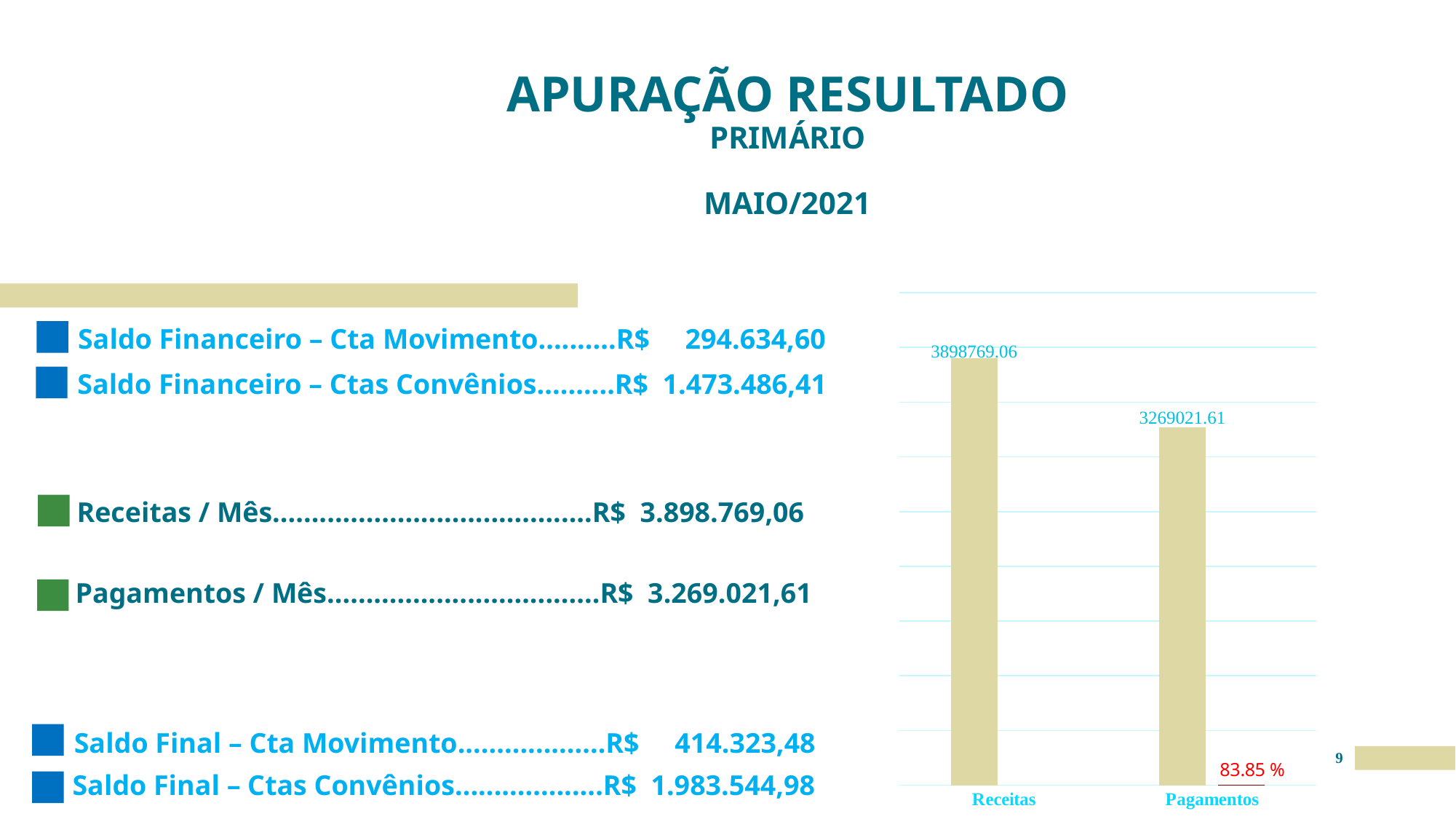
Which is larger in the chart, Receitas or Pagamentos? Receitas What kind of chart is shown on the slide? bar chart What colour are the bars in the chart? beige Do the bar values rise or fall from Receitas to Pagamentos? fall Which category has the lowest bar in the chart? Pagamentos What is the value shown for Pagamentos in the chart? 3269021.61 What percentage is printed in red next to the Pagamentos bar? 83.85 % How many bars are plotted in the chart? 2 What is the value shown for Receitas in the chart? 3898769.06 What is the difference between the Receitas and Pagamentos values in the chart? 629747.45 Which category has the highest bar in the chart? Receitas